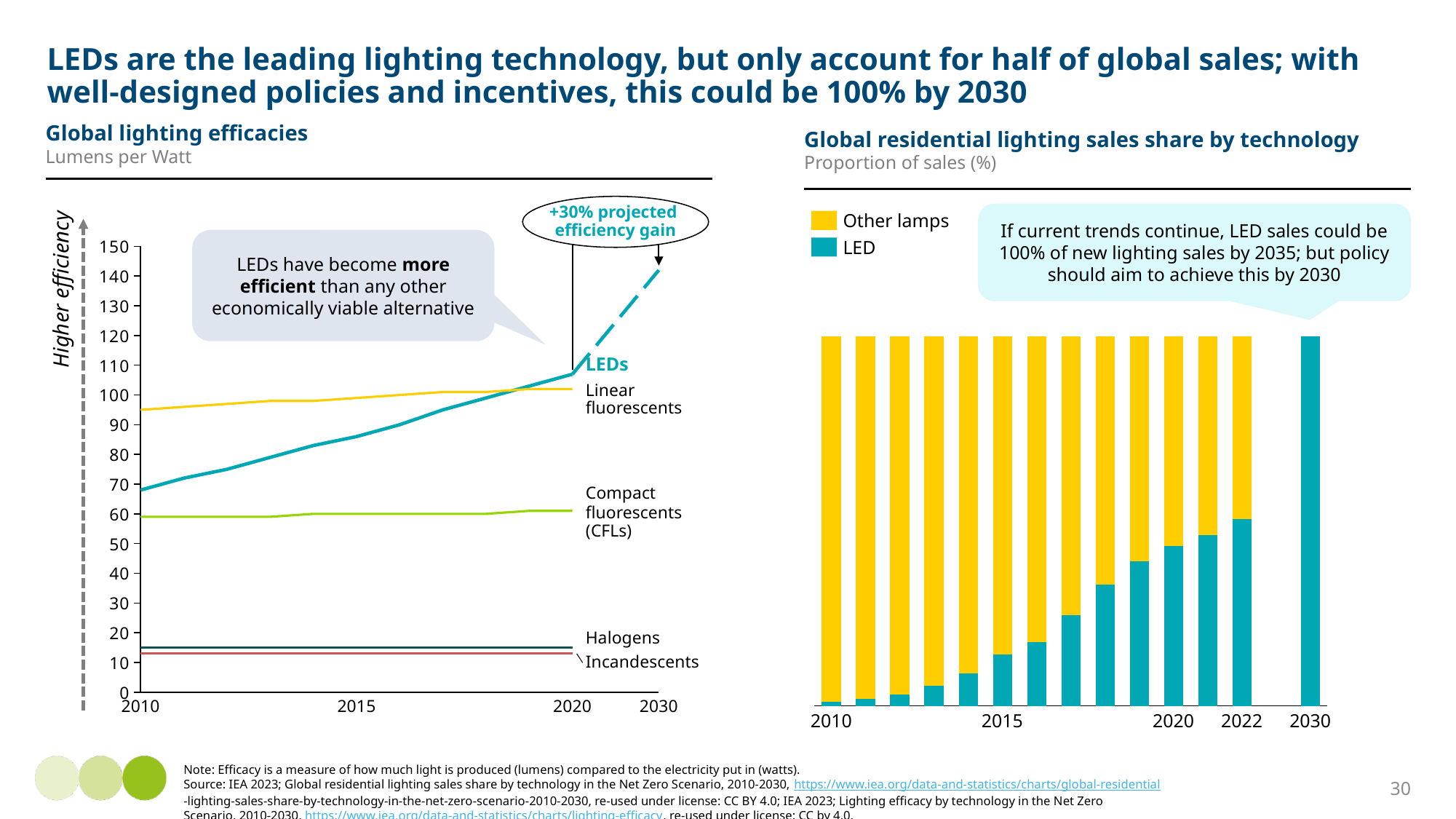
In the 'Global lighting efficacies' chart, is the LED value in 2010 greater or less than 80? less In the 'Global lighting efficacies' chart, which technology has the highest efficacy in 2010? Linear fluorescents What kind of chart is the 'Global lighting efficacies' chart? Line chart How many lighting technologies are plotted as lines in the 'Global lighting efficacies' chart? 5 What kind of chart is the 'Global residential lighting sales share by technology' chart? Bar chart In the 'Global lighting efficacies' chart, is the LED value in 2020 greater or less than 100? greater In the 'Global residential lighting sales share by technology' chart, does the LED share rise or fall from 2010 to 2022? Rises In the 'Global lighting efficacies' chart, does the LED line rise or fall between 2010 and 2020? Rises What unit is shown under the title of the 'Global lighting efficacies' chart? Lumens per Watt How many series does the legend of the 'Global residential lighting sales share by technology' chart list? 2 In the 'Global residential lighting sales share by technology' chart, which series is larger in 2020, Other lamps or LED? Other lamps In the 'Global lighting efficacies' chart, is the value for Compact fluorescents (CFLs) in 2015 greater or less than 70? less